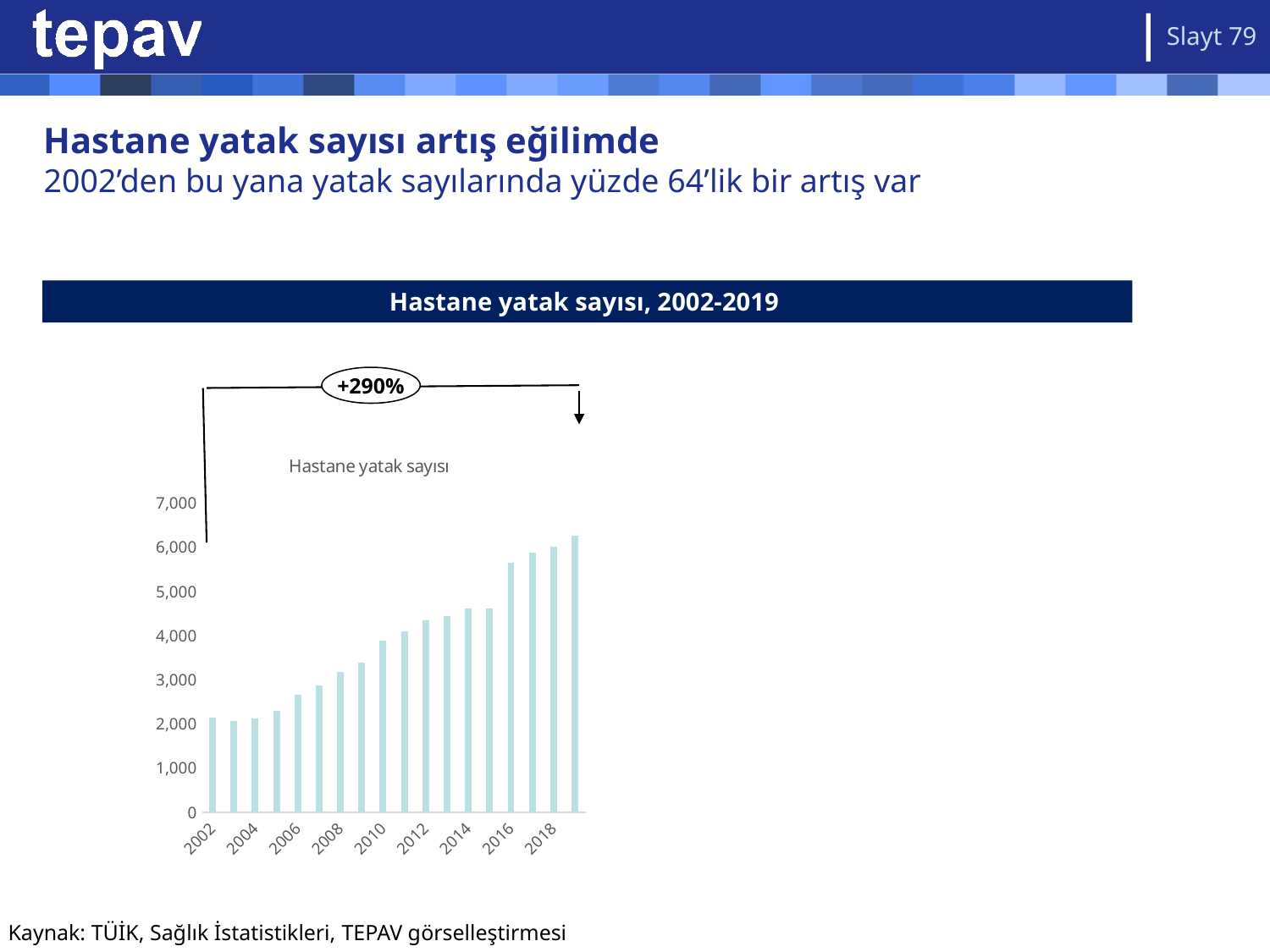
Do the values generally rise or fall from 2002 to 2019? rise Is the value for 2019 greater or less than 6,000? greater Is the value for 2006 greater or less than 3,000? less Which year has the highest hospital bed count in the chart? 2019 What kind of chart is shown on the slide? bar chart Which is larger, the value for 2010 or the value for 2016? 2016 Is the value for 2016 greater or less than 5,000? greater Which is larger, the value for 2002 or the value for 2019? 2019 What percentage change is shown in the annotation above the chart? +290% How many bars (years) are plotted in the chart? 18 What is the title shown in the banner above the chart? Hastane yatak sayısı, 2002-2019